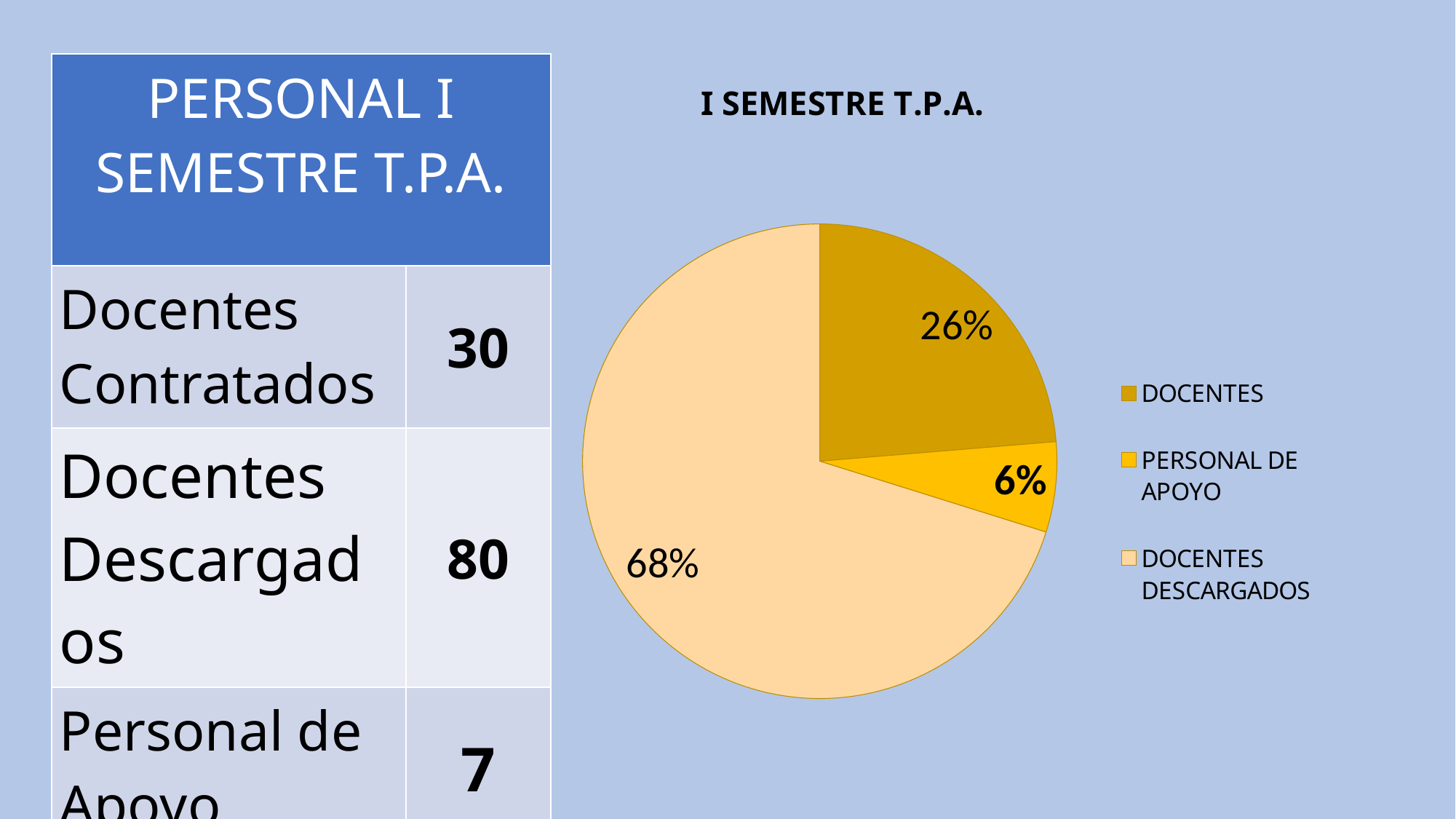
Which category has the largest slice of the pie? DOCENTES DESCARGADOS How many slices does the pie chart have? 3 Which category has the smallest slice of the pie? PERSONAL DE APOYO What share of the pie does DOCENTES represent? 26% How many entries does the chart legend list? 3 What is the title of the chart? I SEMESTRE T.P.A. What share of the pie does DOCENTES DESCARGADOS represent? 68% Which legend entry is shown in the lightest colour? DOCENTES DESCARGADOS What share of the pie does PERSONAL DE APOYO represent? 6% What kind of chart is shown on the slide? pie chart What is the difference in percentage points between the DOCENTES DESCARGADOS slice and the DOCENTES slice? 42 Which slice is larger, DOCENTES or PERSONAL DE APOYO? DOCENTES